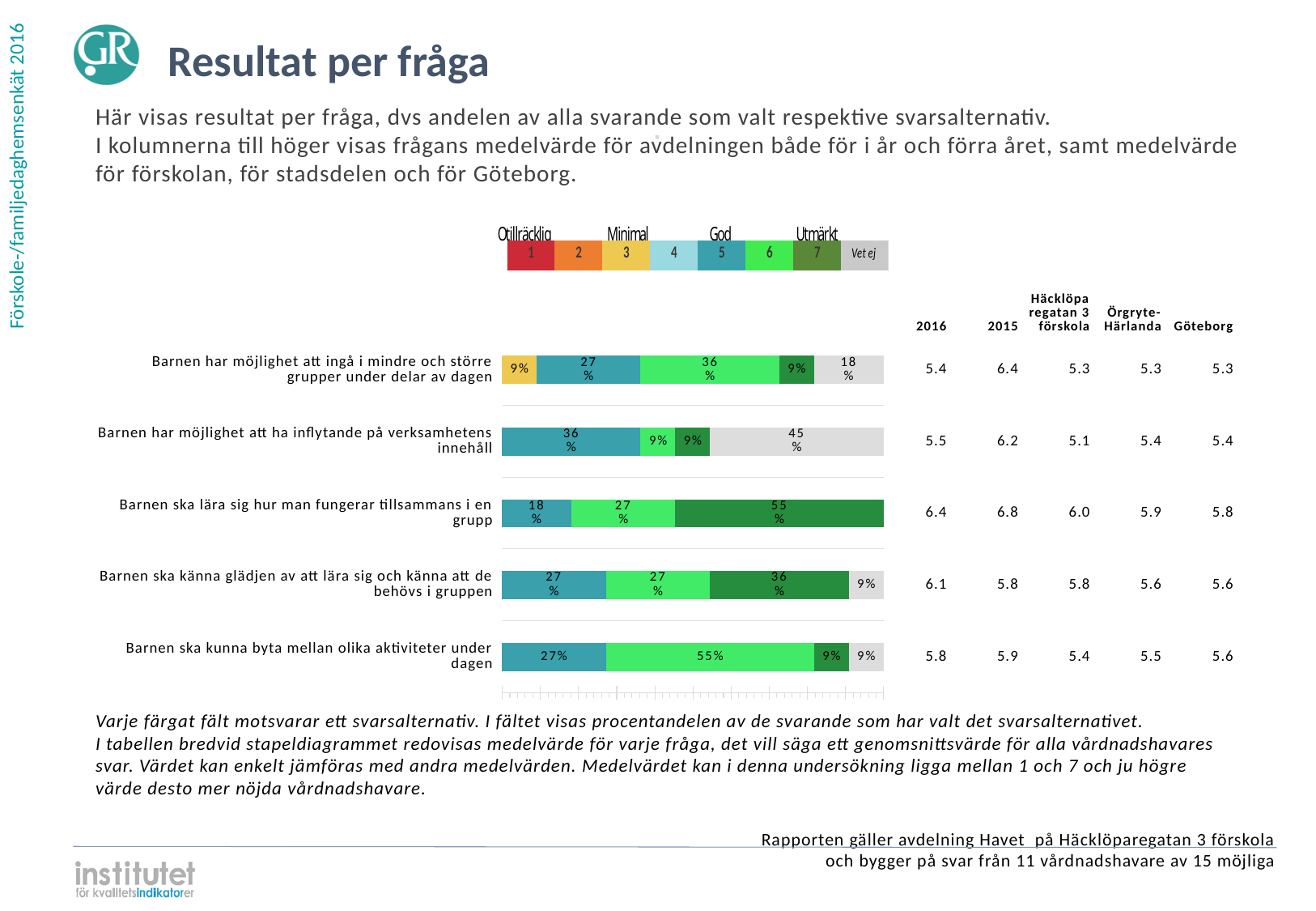
How many questions (categories) are plotted in the bar chart? 5 Which question has the largest 'Vet ej' (grey) share? Barnen har möjlighet att ha inflytande på verksamhetens innehåll What is the total of the stacked bar for 'Barnen ska lära sig hur man fungerar tillsammans i en grupp' (18% + 27% + 55%)? 100% How many entries does the colour legend above the chart list? 8 What percentage of respondents chose 'Vet ej' for 'Barnen har möjlighet att ha inflytande på verksamhetens innehåll'? 45% What percentage chose rating 6 (light green) for 'Barnen ska kunna byta mellan olika aktiviteter under dagen'? 55% Which rating label in the legend corresponds to the dark green colour (7)? Utmärkt What percentage chose rating 7 (dark green) for 'Barnen ska lära sig hur man fungerar tillsammans i en grupp'? 55% In the table next to the chart, what is the 2016 mean for 'Barnen ska lära sig hur man fungerar tillsammans i en grupp'? 6.4 What kind of chart is shown on the slide? Stacked bar chart Which is larger: the rating 5 (teal) share for 'Barnen har möjlighet att ha inflytande på verksamhetens innehåll' or for 'Barnen ska lära sig hur man fungerar tillsammans i en grupp'? Barnen har möjlighet att ha inflytande på verksamhetens innehåll What is the difference between the rating 7 share for 'Barnen ska lära sig hur man fungerar tillsammans i en grupp' (55%) and for 'Barnen ska känna glädjen av att lära sig och känna att de behövs i gruppen' (36%)? 19 percentage points